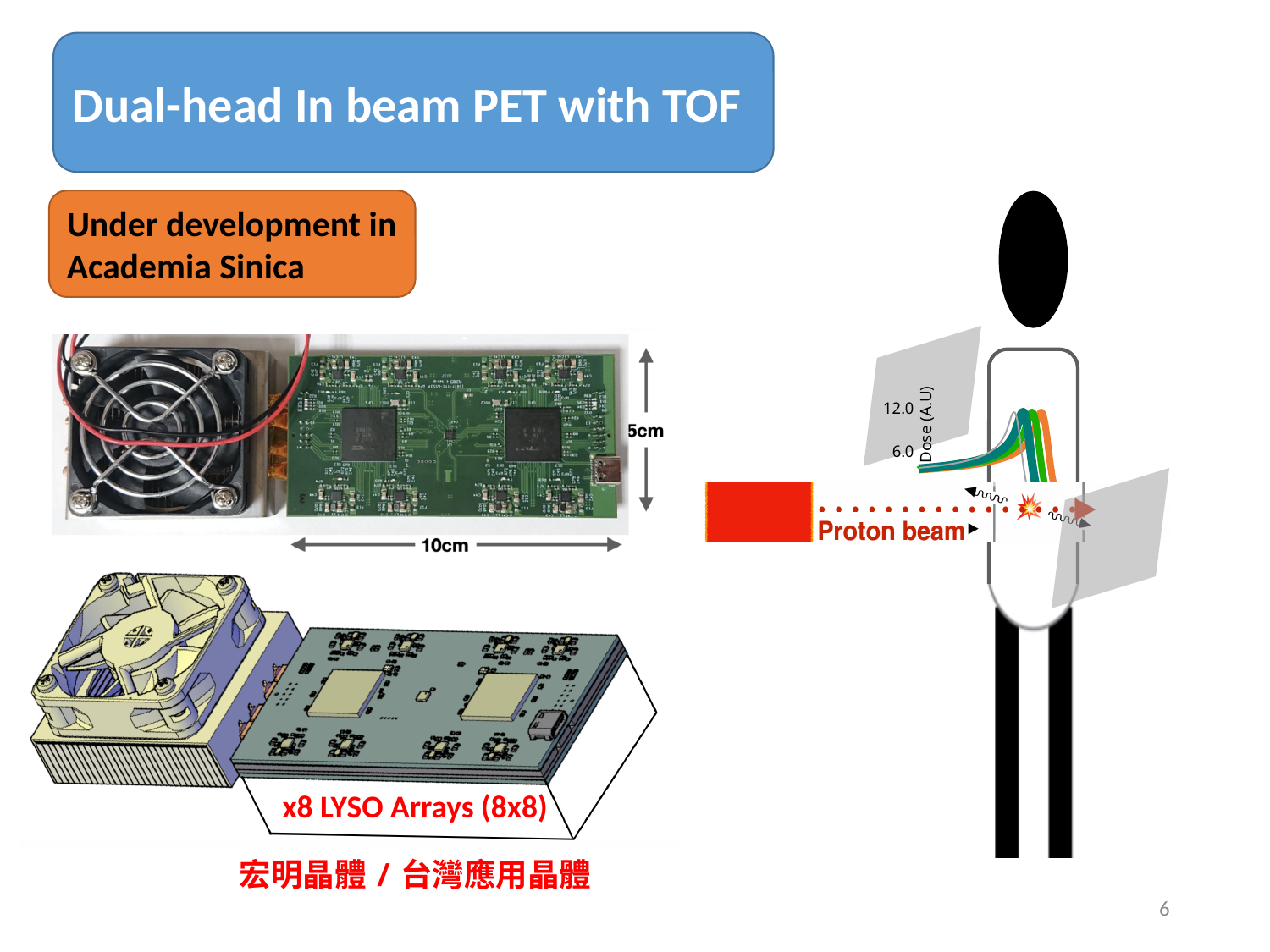
Is the peak value of the dose curves greater or less than 6.0? greater What is the highest tick value printed on the vertical axis of the dose plot? 12.0 What is the label of the vertical axis on the dose plot? Dose (A.U) How do the dose curves behave along the x axis in the direction of the proton beam? rise to a peak then fall sharply What kind of chart is the dose plot overlaid on the patient figure? line chart